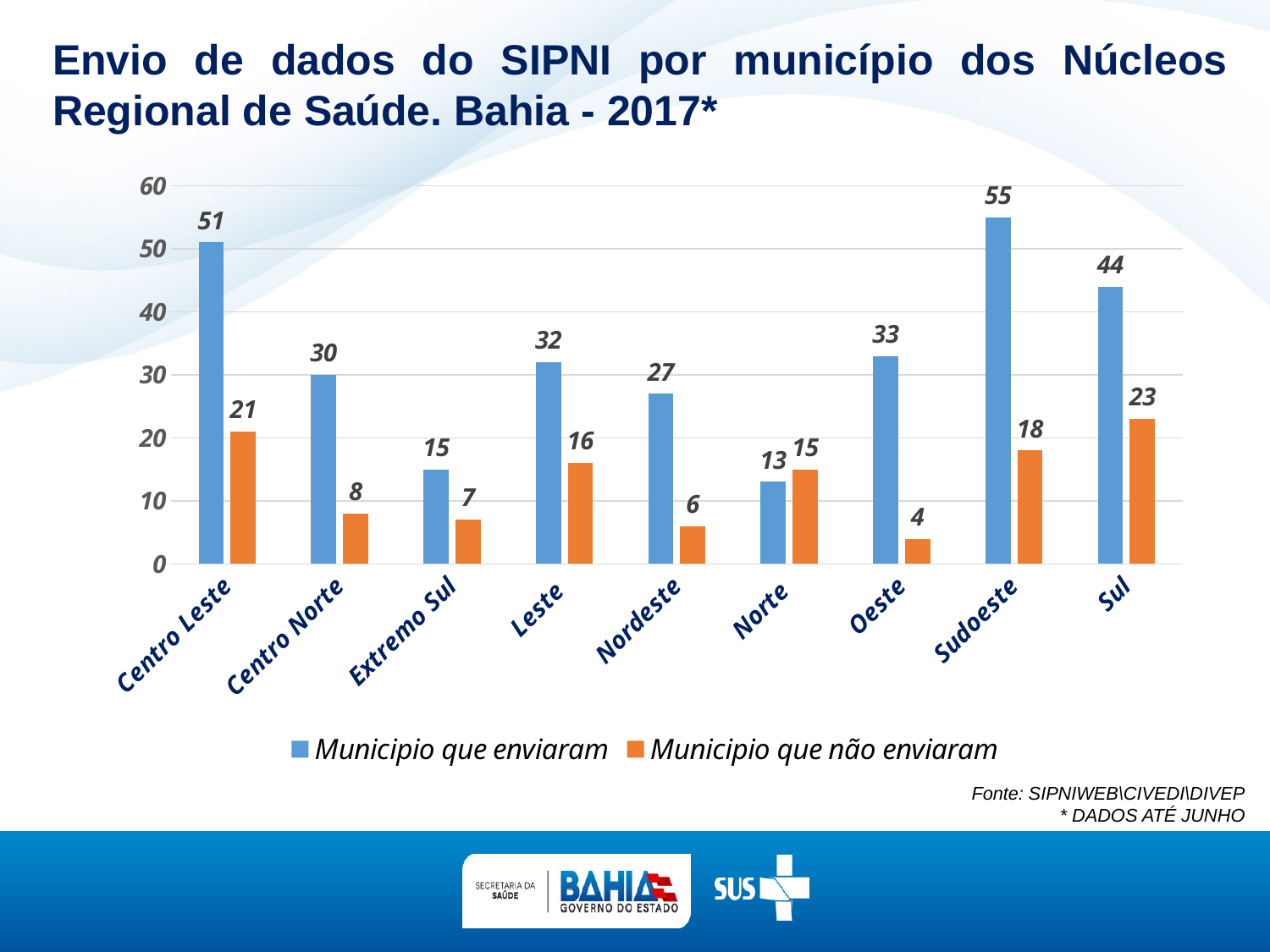
How many categories are shown on the x axis? 9 Is the value for 'Municipio que enviaram' in Centro Leste greater or less than 50? greater What colour are the bars for 'Municipio que não enviaram'? orange How many series does the legend list? 2 Which category has the lowest value for 'Municipio que não enviaram'? Oeste What kind of chart is shown on the slide? bar chart What is the value for 'Municipio que não enviaram' in Centro Leste? 21 What is the value for 'Municipio que enviaram' in Sudoeste? 55 Which category has the highest value for 'Municipio que enviaram'? Sudoeste What is the difference between 'Municipio que enviaram' and 'Municipio que não enviaram' in Sul? 21 In Norte, which is larger: 'Municipio que enviaram' or 'Municipio que não enviaram'? Municipio que não enviaram What is the value for 'Municipio que enviaram' in Norte? 13